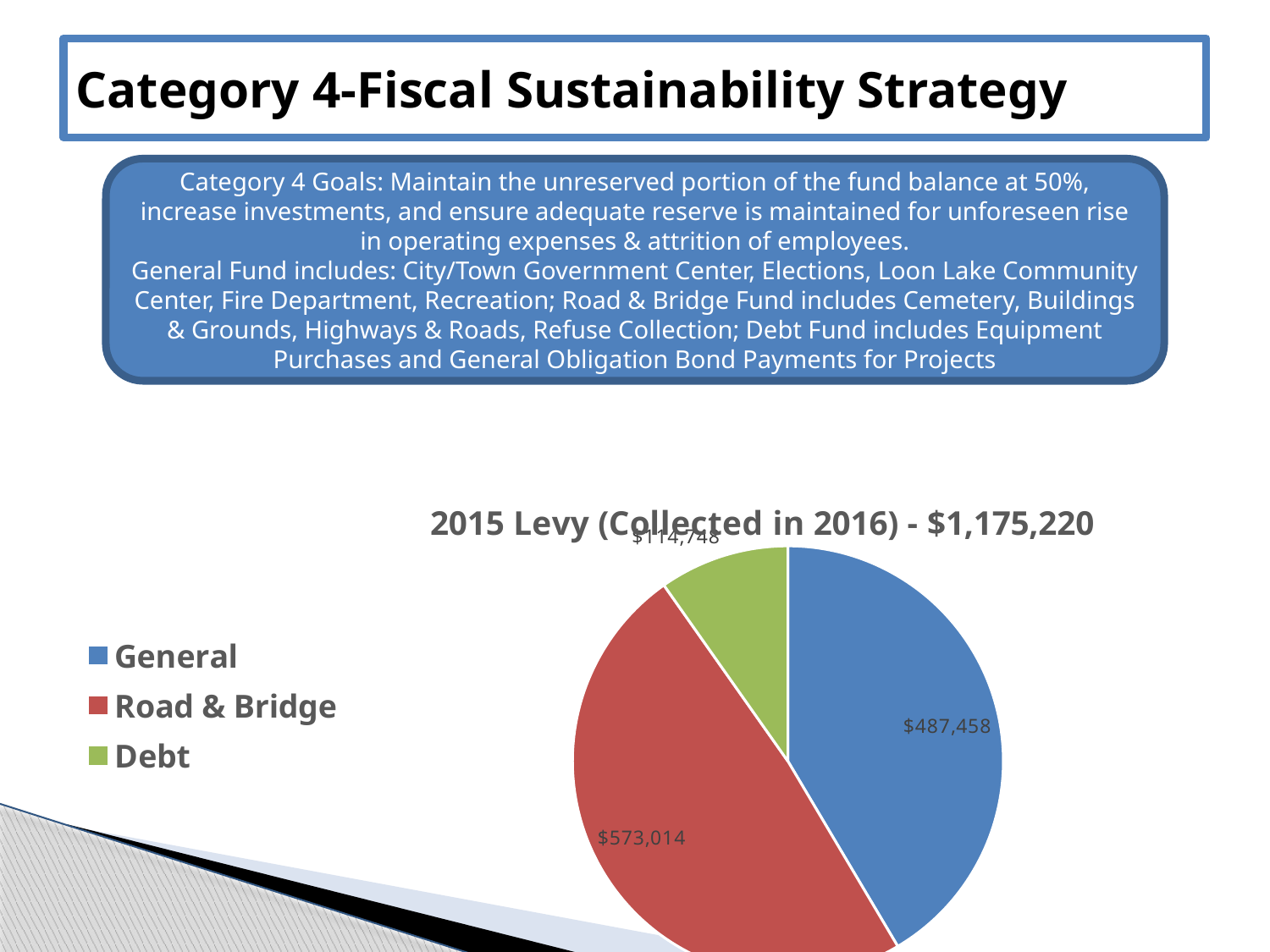
What colour is the Debt slice in the pie chart? green How many categories does the legend of the pie chart list? 3 Which category has the largest slice in the pie chart? Road & Bridge What type of chart is shown on the slide? pie chart What is the title of the pie chart? 2015 Levy (Collected in 2016) - $1,175,220 What is the difference between the General value and the Debt value in the pie chart? $372,710 What is the value of the Debt slice in the pie chart? $114,748 Which is larger in the pie chart, General or Road & Bridge? Road & Bridge What is the value of the Road & Bridge slice in the pie chart? $573,014 Which category has the smallest slice in the pie chart? Debt What is the difference between the Road & Bridge value and the General value in the pie chart? $85,556 What is the value of the General slice in the pie chart? $487,458